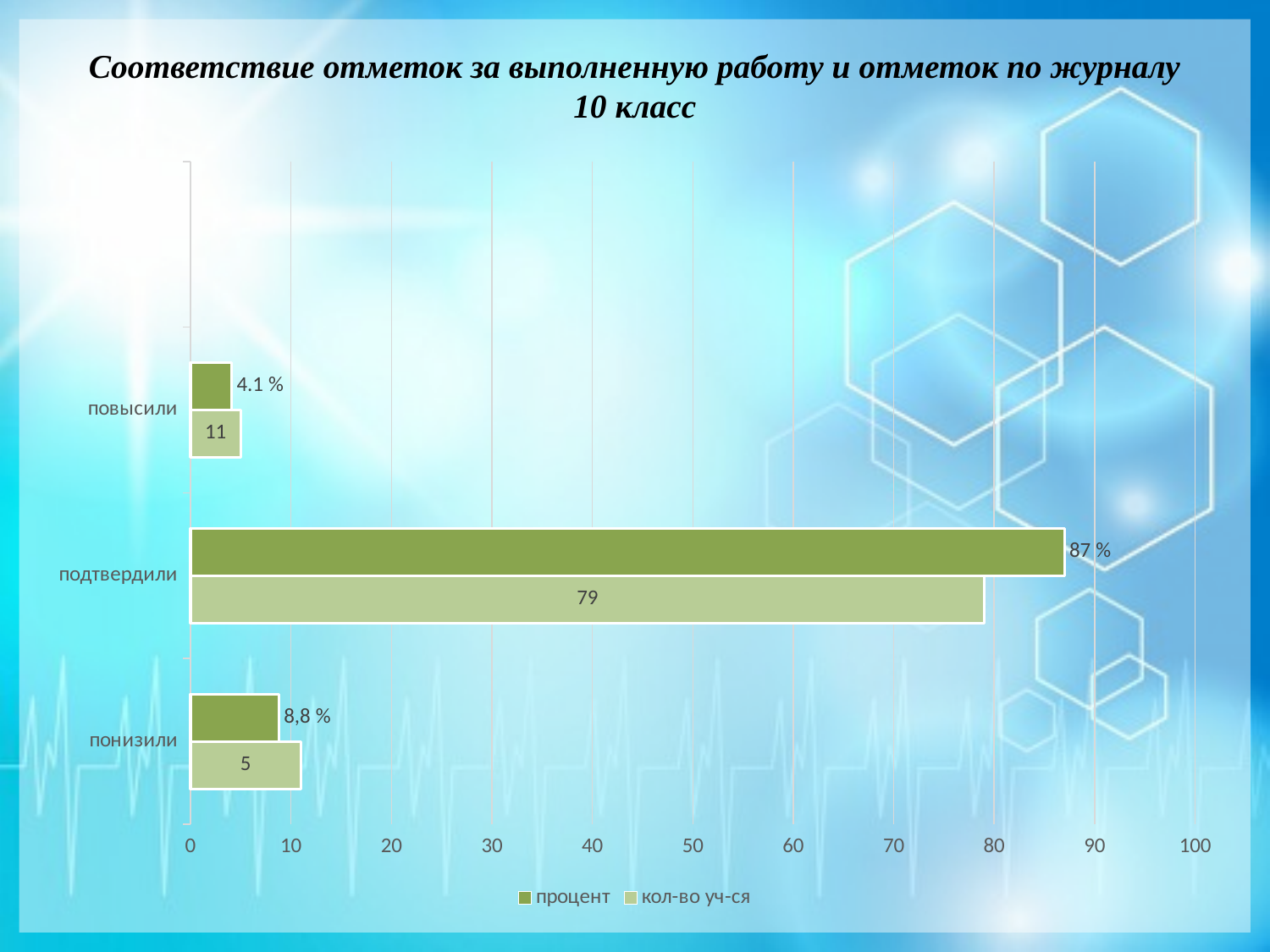
What is the value of the процент series for повысили? 4.1 % What kind of chart is shown on the slide? bar chart What is the value of the кол-во уч-ся series for понизили? 5 Which category has the lowest value in the процент series? повысили Is the кол-во уч-ся value for подтвердили greater or less than 70? greater How many categories are shown on the vertical axis? 3 How many series does the legend list? 2 Which series is shown in the darker green colour? процент What is the value of the кол-во уч-ся series for подтвердили? 79 Which category has the highest value in the кол-во уч-ся series? подтвердили What is the value of the процент series for подтвердили? 87 % What is the value of the процент series for понизили? 8,8 %